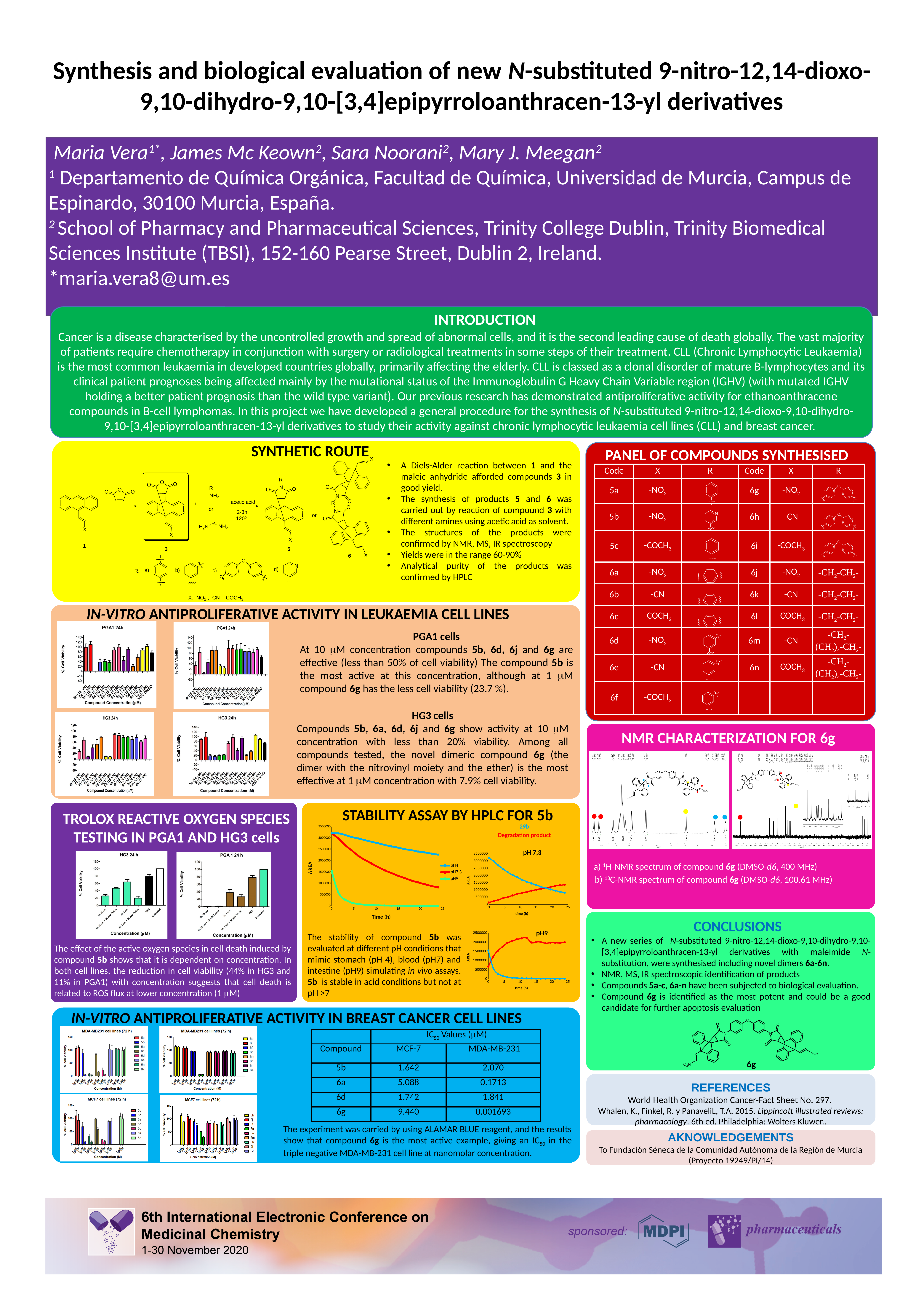
In the large stability assay chart for 5b, does the pH9 series rise or fall over time? fall What kind of charts are shown in the 'In-vitro antiproliferative activity in leukaemia cell lines' panel? bar chart In the 'Stability assay by HPLC for 5b' panel, what are the three series named in the legend of the large chart? pH4, pH7.3, pH9 In the 'Stability assay by HPLC for 5b' panel, how many series does the legend of the large chart list? 3 In the 'Trolox reactive oxygen species testing' panel, what kind of chart is the 'HG3 24 h' chart? bar chart In the large stability assay chart for 5b, which series has the lowest AREA at the end of the time axis? pH9 In the large stability assay chart for 5b, which series has the highest AREA at the end of the time axis? pH4 In the small 'pH9' stability chart, does the red series rise or fall over time? rise What is the x-axis label of the large stability assay chart for 5b? Time (h) In the 'Stability assay by HPLC for 5b' panel, what kind of chart is the large chart on the left? line chart How many charts are shown in the 'In-vitro antiproliferative activity in breast cancer cell lines' panel? 4 In the large stability assay chart for 5b, is the AREA of the pH9 series at 25 h greater or less than 500000? less